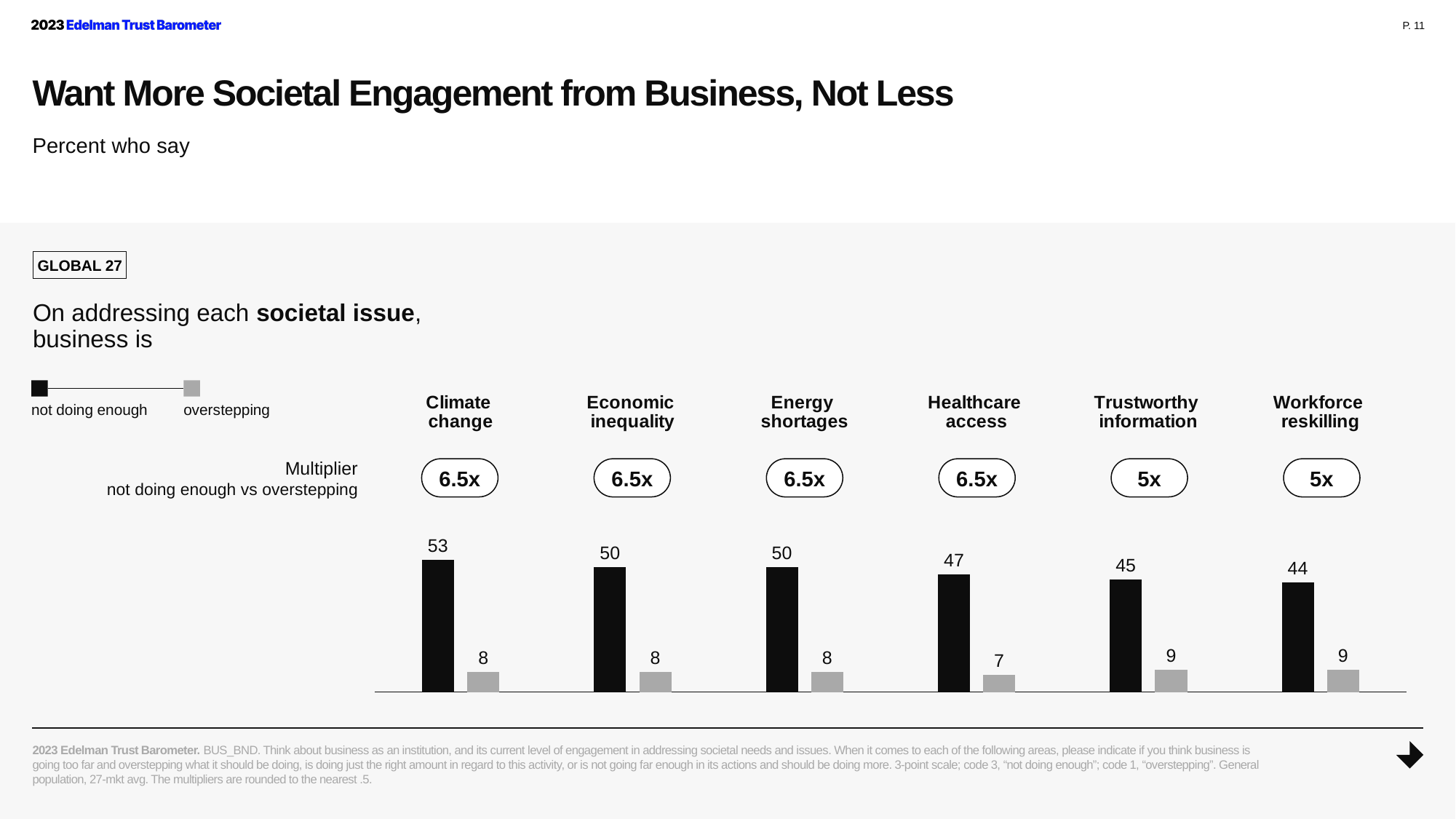
What percent say business is not doing enough on workforce reskilling? 44 Which is larger: the not doing enough value for economic inequality or for trustworthy information? Economic inequality What kind of chart is shown on the slide? Bar chart What is the difference between the not doing enough and overstepping values for energy shortages? 42 How many series does the legend list? 2 Which societal issue has the highest percent saying business is not doing enough? Climate change What percent say business is overstepping on healthcare access? 7 What percent say business is not doing enough on climate change? 53 What multiplier is shown for trustworthy information? 5x Which societal issue has the lowest percent saying business is overstepping? Healthcare access How many societal issues are shown in the chart? 6 Do the not doing enough values rise or fall from climate change to workforce reskilling? Fall